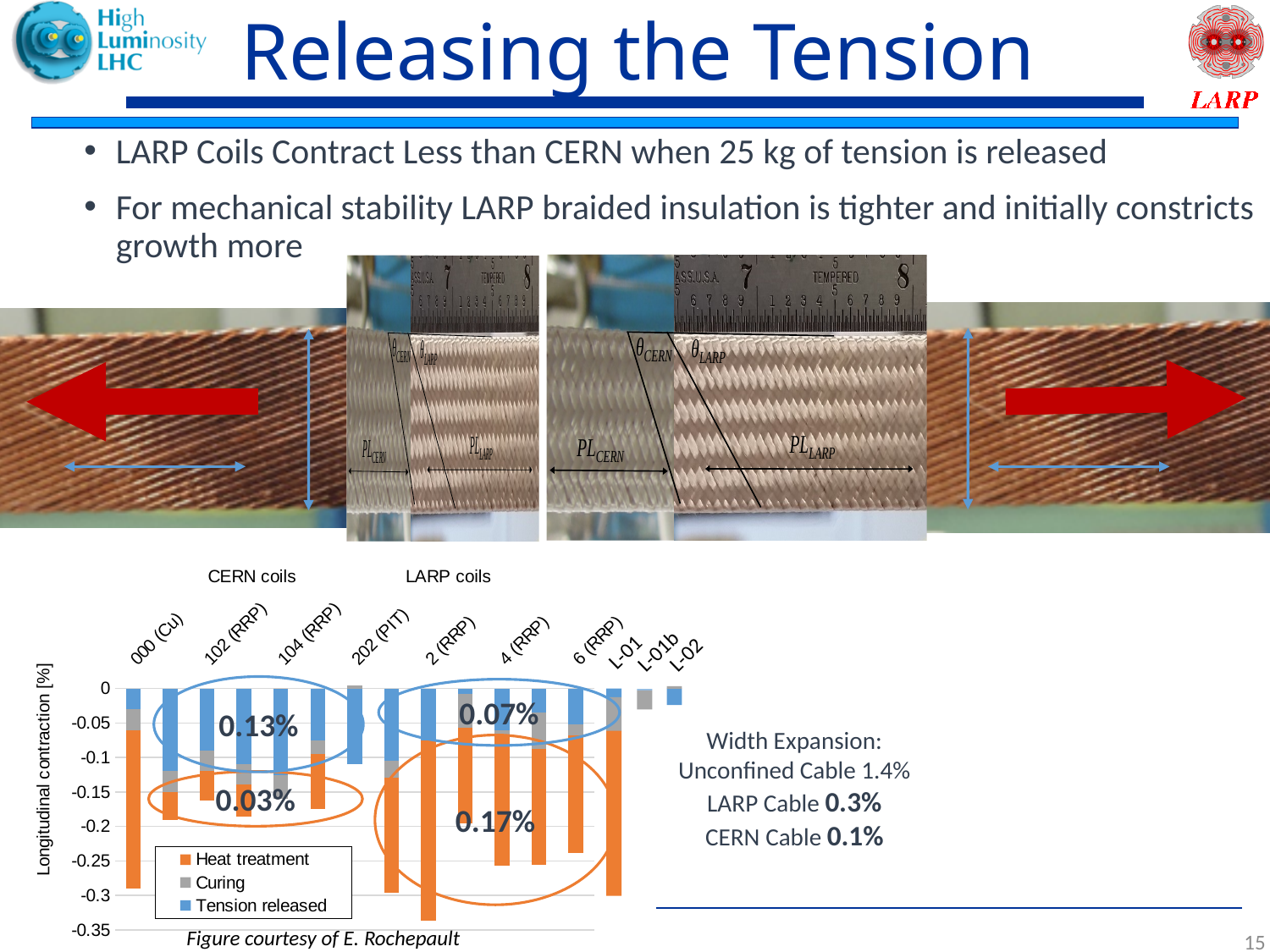
According to the annotation on the bar chart, what is the tension-released contraction for the LARP coils? 0.07% Does the bottom of the stacked bar for 2 (RRP) lie above or below the -0.3 gridline? below What are the three series named in the legend of the bar chart? Heat treatment, Curing, Tension released What kind of chart is shown at the bottom left of the slide? bar chart According to the annotation on the bar chart, what is the heat-treatment contraction for the LARP coils? 0.17% What is the label of the vertical axis of the bar chart? Longitudinal contraction [%] According to the annotation on the bar chart, what is the tension-released contraction for the CERN coils? 0.13% What is the difference between the annotated tension-released contraction of the CERN coils (0.13%) and the LARP coils (0.07%)? 0.06% How many series does the legend of the bar chart list? 3 Which group shows the larger annotated heat-treatment contraction, CERN coils (0.03%) or LARP coils (0.17%)? LARP coils